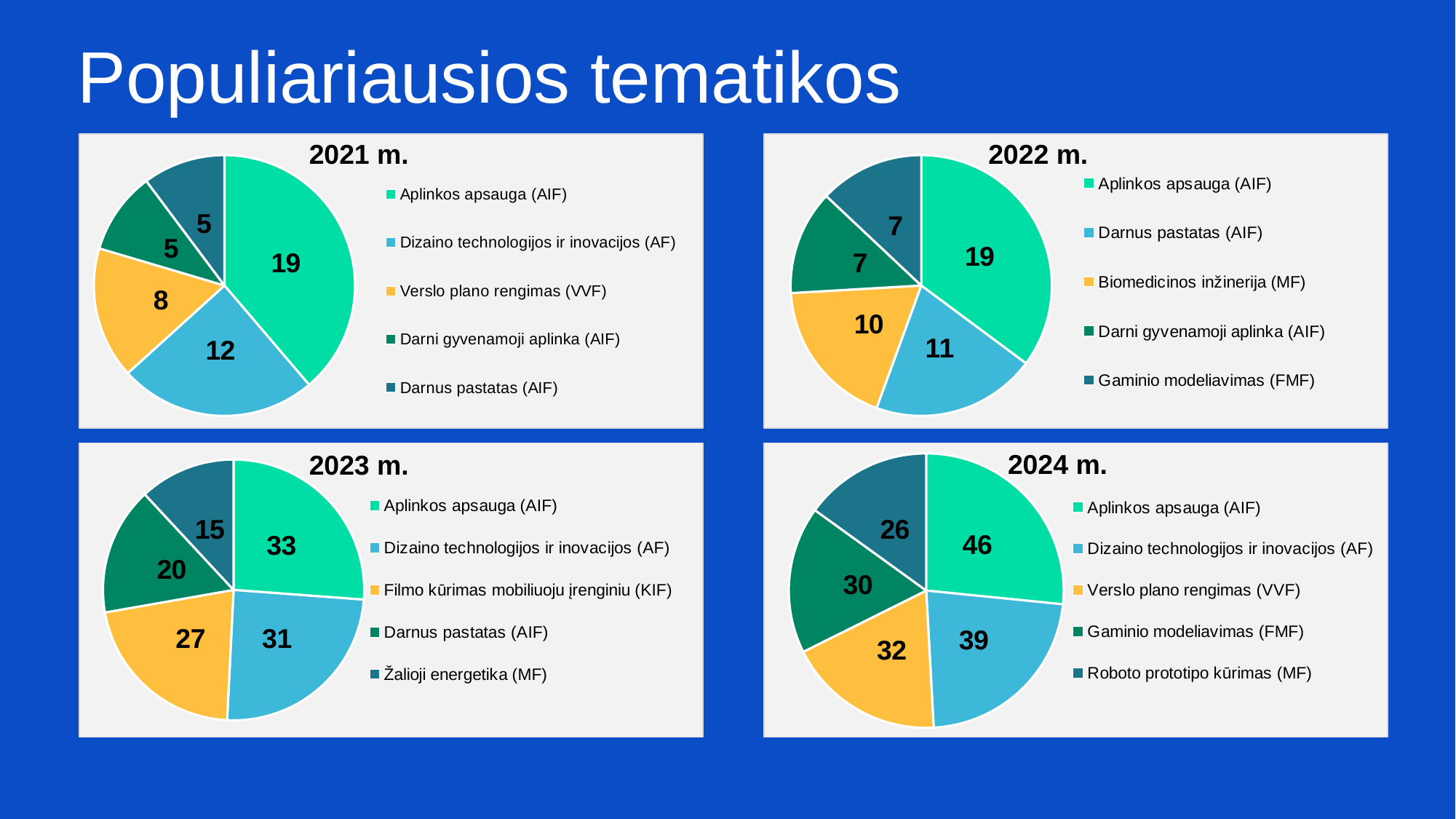
How many charts are shown on the slide? 4 In the 2023 m. chart, which category has the smallest slice? Žalioji energetika (MF) In the 2024 m. chart, which category has the largest slice? Aplinkos apsauga (AIF) What type of chart is used for 2023 m.? Pie chart In the 2023 m. chart, what is the value for Filmo kūrimas mobiliuoju įrenginiu (KIF)? 27 What is the total of all slices in the 2021 m. chart? 49 In the 2022 m. chart, what is the difference between Aplinkos apsauga (AIF) and Darnus pastatas (AIF)? 8 How many categories does the 2021 m. chart show? 5 In the 2024 m. chart, which is larger: Verslo plano rengimas (VVF) or Gaminio modeliavimas (FMF)? Verslo plano rengimas (VVF) In the 2022 m. chart, what is the value for Biomedicinos inžinerija (MF)? 10 In the 2021 m. chart, what is the value for Dizaino technologijos ir inovacijos (AF)? 12 In the 2024 m. chart, what is the value for Roboto prototipo kūrimas (MF)? 26